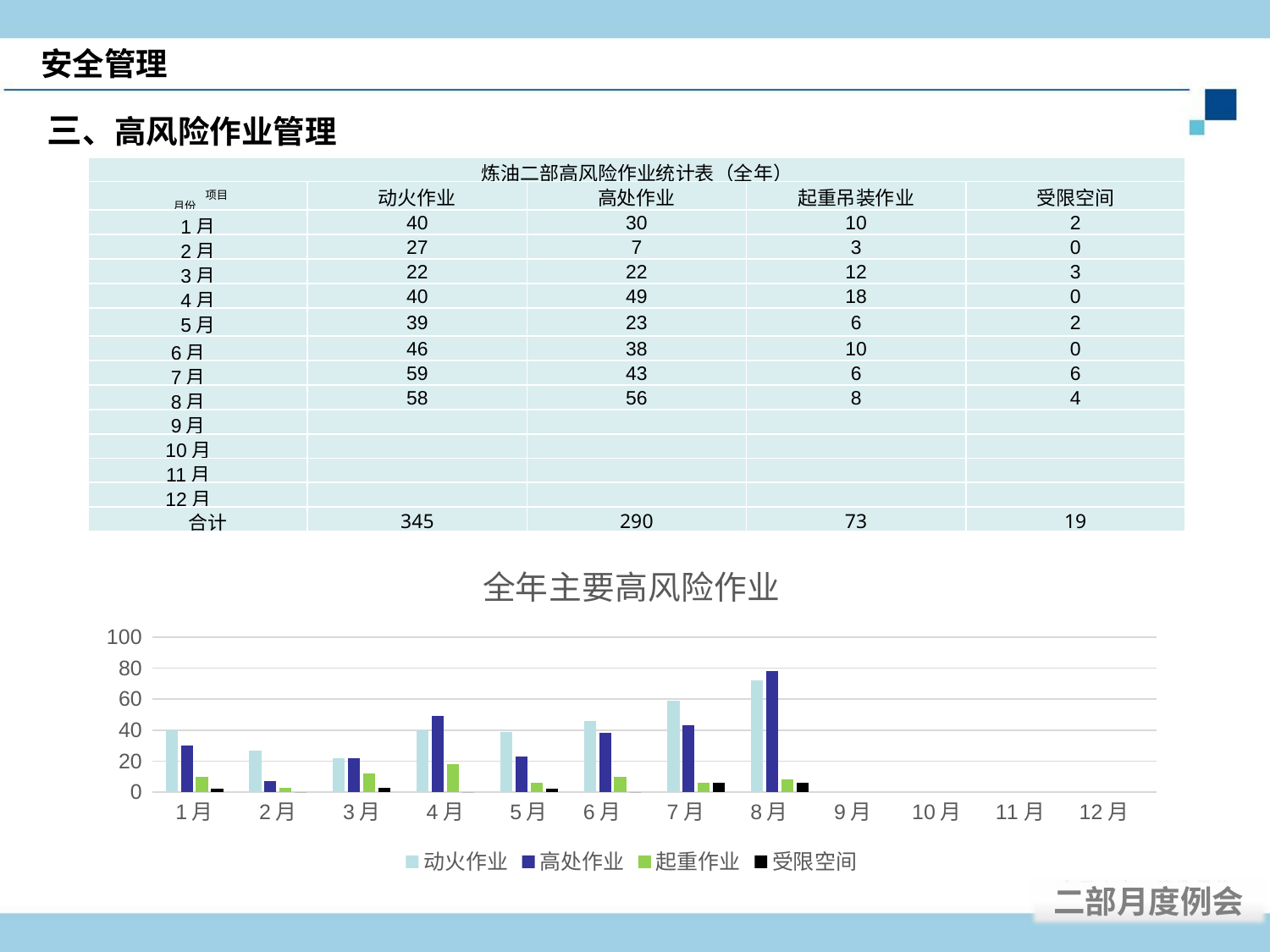
In the 全年主要高风险作业 chart, what colour represents 受限空间 in the legend? black In the 全年主要高风险作业 chart, is the 起重作业 value for 4月 greater or less than 10? greater In the 全年主要高风险作业 chart, do the 动火作业 bars rise or fall from 5月 to 8月? rise In the 全年主要高风险作业 chart, is the 高处作业 value for 2月 greater or less than 20? less What kind of chart is shown under the title 全年主要高风险作业? bar chart How many series does the legend of the 全年主要高风险作业 chart list? 4 In the 全年主要高风险作业 chart, is the 动火作业 value for 7月 greater or less than 40? greater What is the title of the chart on the slide? 全年主要高风险作业 In the 全年主要高风险作业 chart, what is the 动火作业 value for 1月? 40 In the 全年主要高风险作业 chart, which month has the highest 高处作业 bar? 8月 In the 全年主要高风险作业 chart, which is larger for 4月: 动火作业 or 高处作业? 高处作业 How many month categories are shown on the x axis of the 全年主要高风险作业 chart? 12